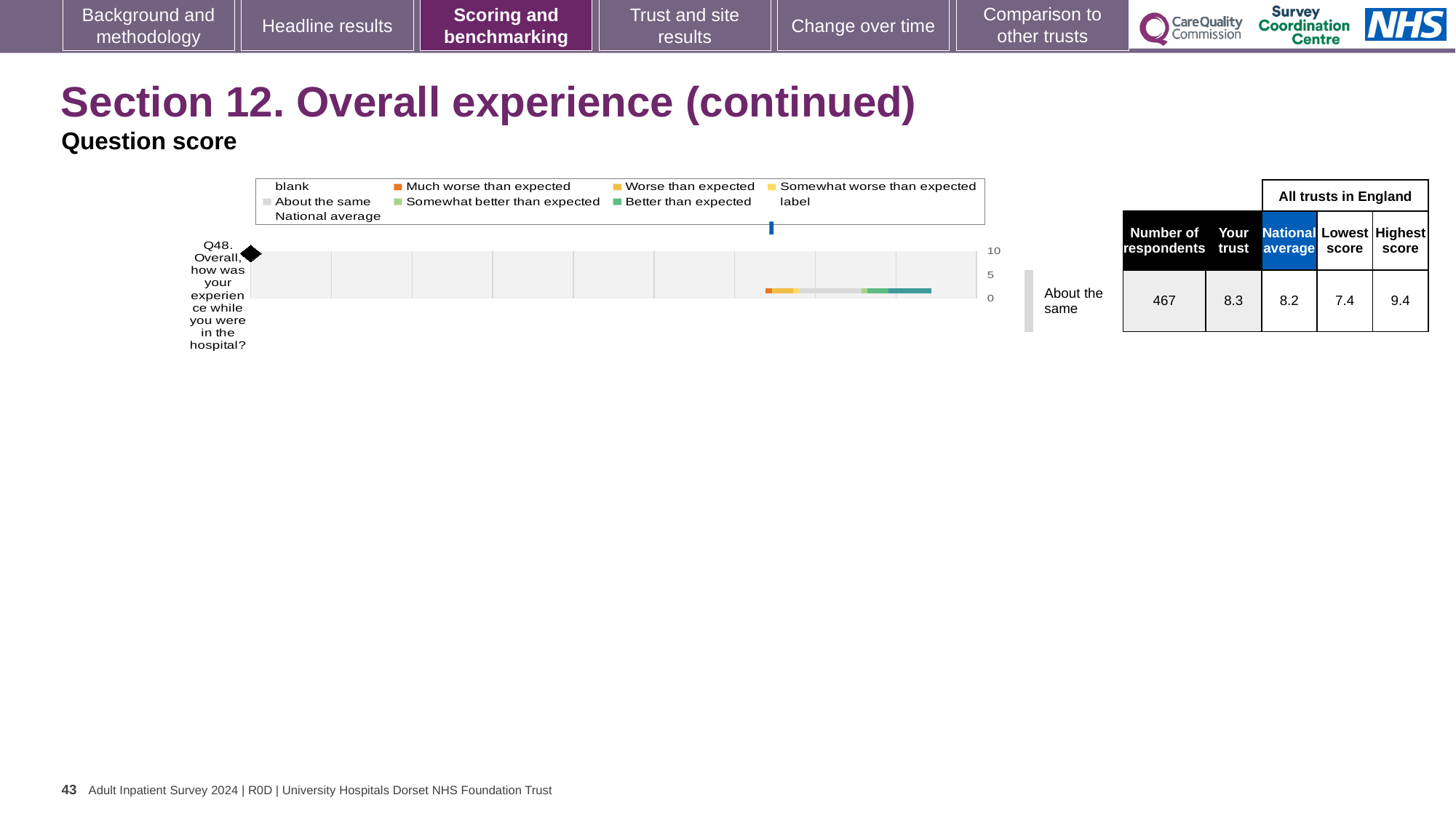
How many respondents answered Q48? 467 What is the lowest score among all trusts in England for Q48? 7.4 How many entries does the chart legend list? 9 What is the highest value shown on the chart's axis? 10 Which is larger for Q48, the 'Your trust' score or the national average? Your trust How many questions are plotted in the chart? 1 What is the highest score among all trusts in England for Q48? 9.4 What is the difference between the highest score and the lowest score for Q48? 2.0 What is the national average score for Q48? 8.2 What kind of chart is shown on the slide? Bar chart Which question is plotted in the chart? Q48. Overall, how was your experience while you were in the hospital? What is the 'Your trust' score for Q48? 8.3